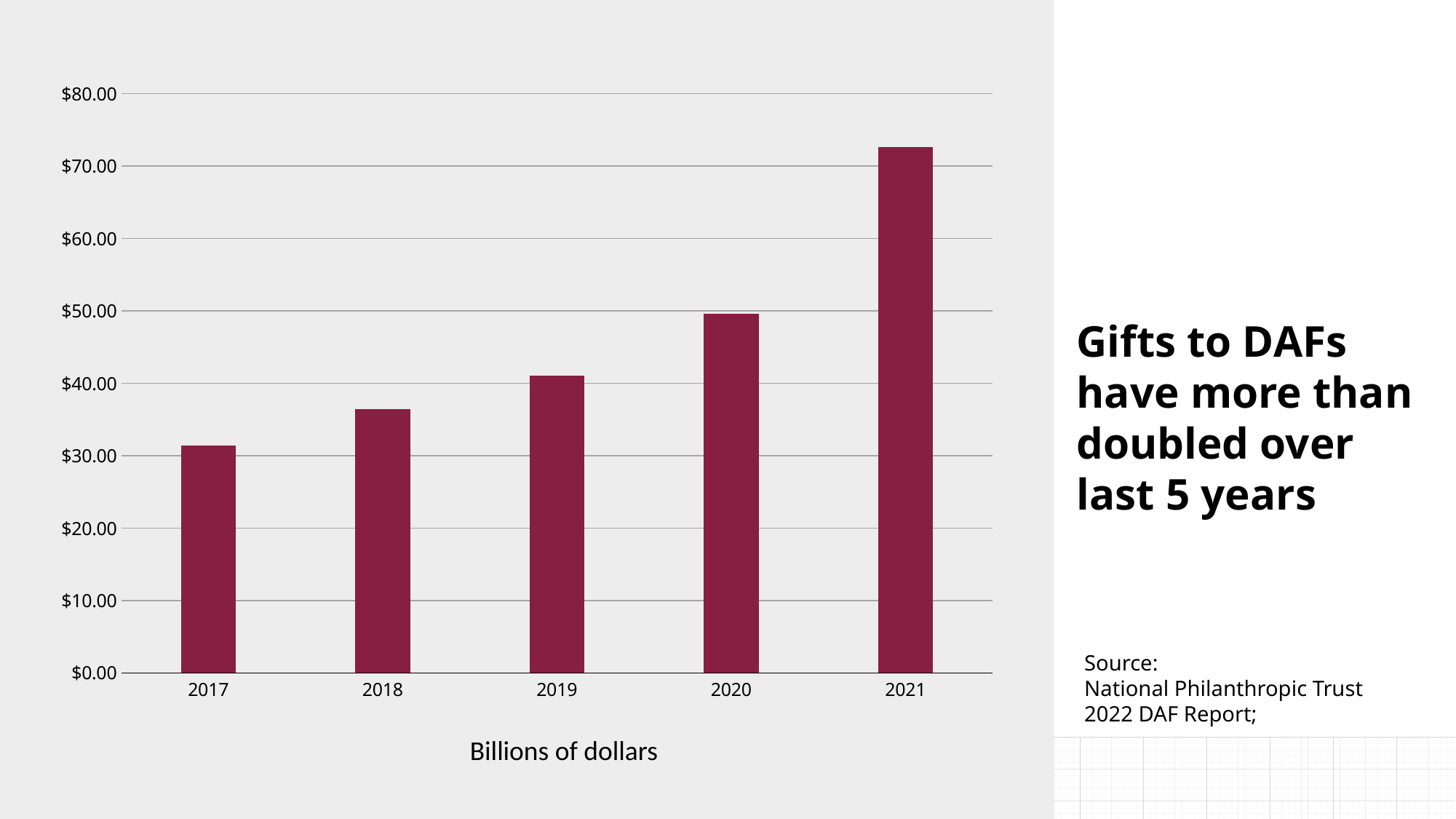
Is the value for 2018 greater or less than $40.00? less Is the value for 2020 greater or less than $40.00? greater Which year has the highest value? 2021 Which year has the lowest value? 2017 What kind of chart is shown on the slide? bar chart Which is larger, the value for 2017 or the value for 2019? 2019 Is the value for 2019 greater or less than $50.00? less What unit is given in the label below the x axis? Billions of dollars Do the values rise or fall from 2017 to 2021? rise Which is larger, the value for 2020 or the value for 2021? 2021 How many years are plotted on the chart? 5